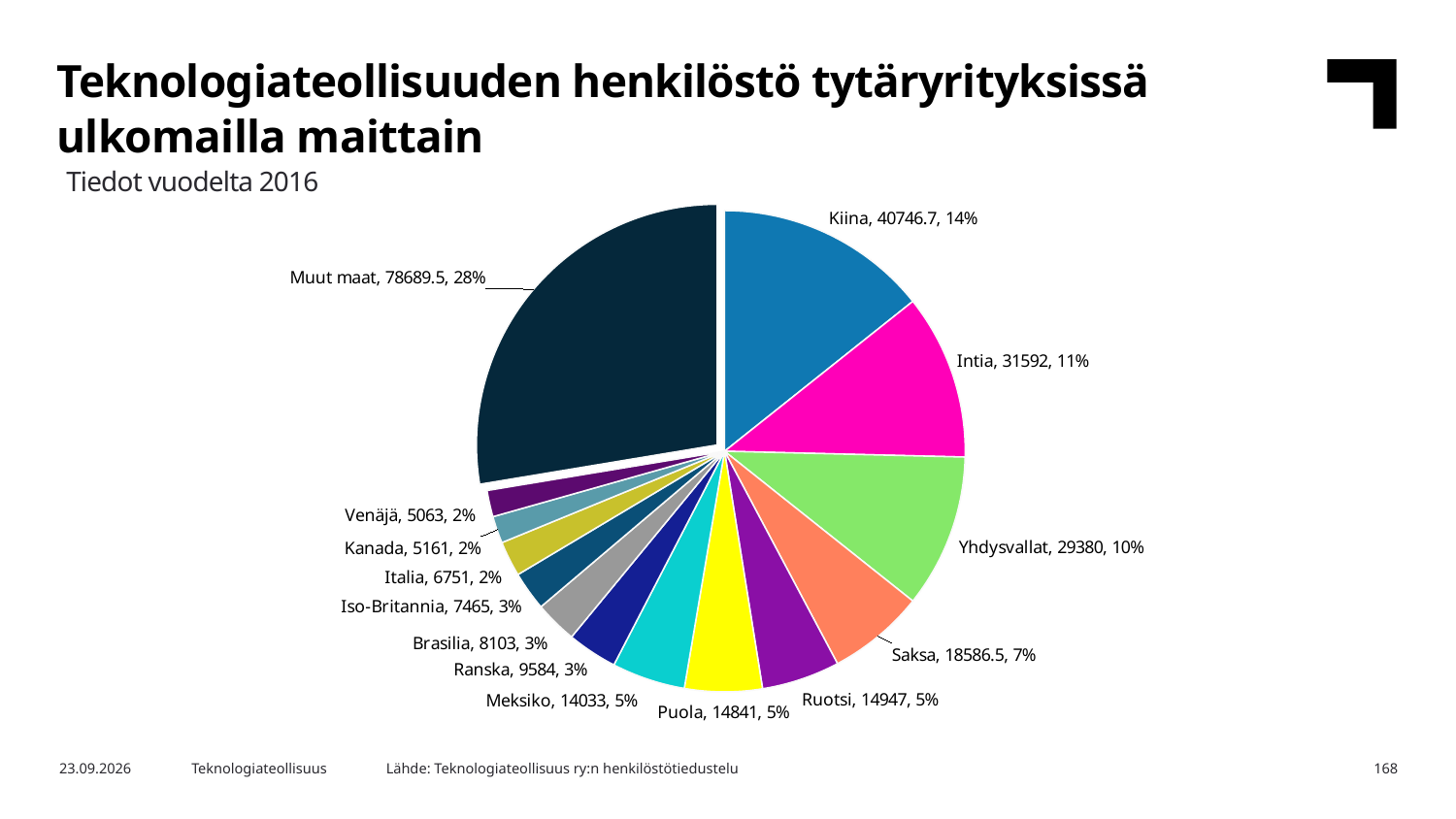
What is the difference between the values for Ruotsi and Puola? 106 What share of the pie does Muut maat represent? 28% What is the value for Saksa? 18586.5 What year do the data on the slide come from? 2016 Which is larger, the value for Yhdysvallat or the value for Intia? Intia What share of the pie does Intia represent? 11% What type of chart is shown on the slide? pie chart What is the value for Kiina? 40746.7 Which slice is the smallest? Venäjä Which slice is the largest? Muut maat What is the value for Meksiko? 14033 How many slices does the pie chart have? 14